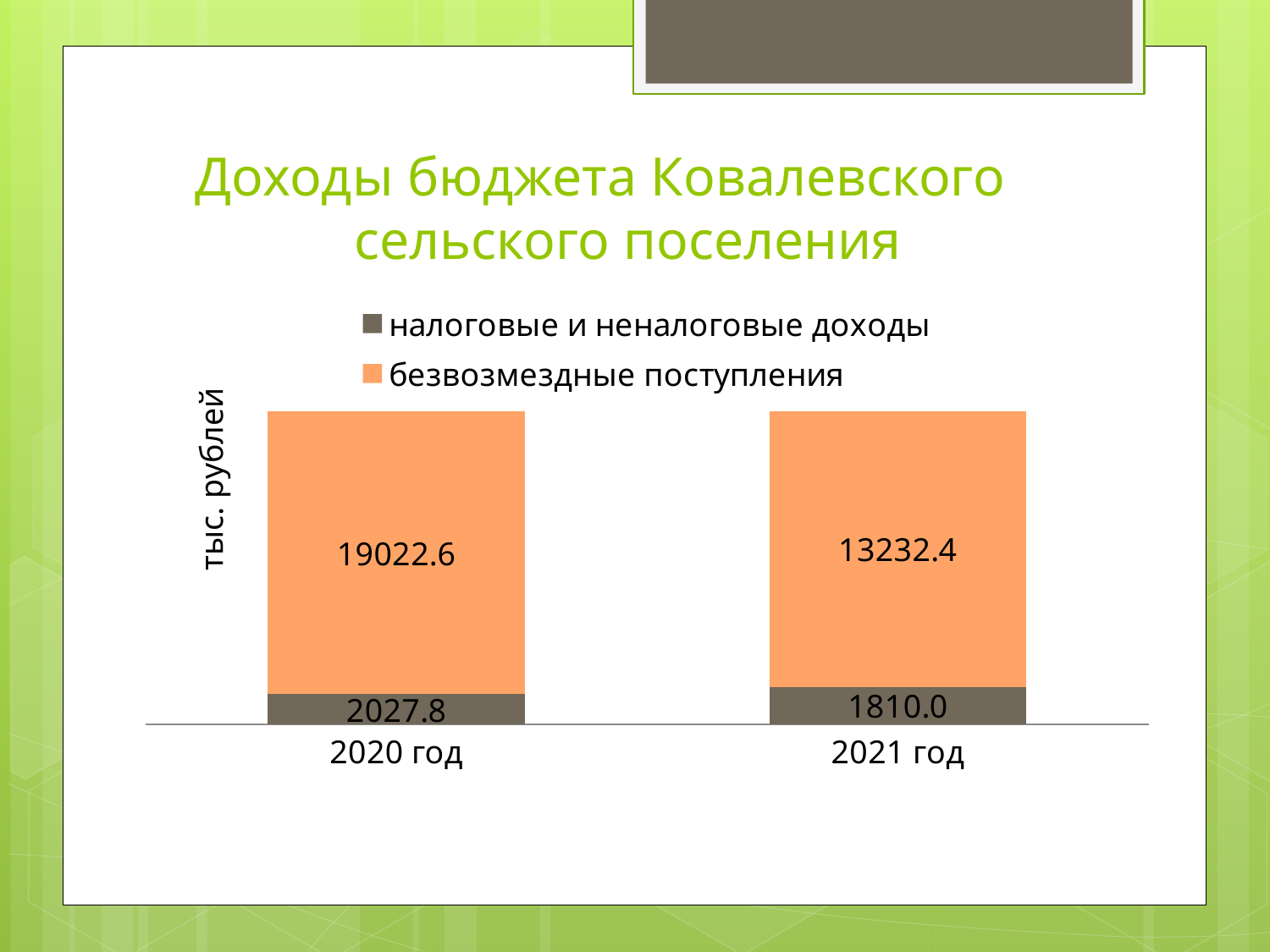
How many series does the legend list? 2 What is the value of налоговые и неналоговые доходы for 2021 год? 1810.0 What is the total of the stacked bar for 2021 год? 15042.4 What is the total of the stacked bar for 2020 год? 21050.4 What is the value of налоговые и неналоговые доходы for 2020 год? 2027.8 In which year is безвозмездные поступления higher? 2020 год In which year is налоговые и неналоговые доходы lower? 2021 год What is the value of безвозмездные поступления for 2020 год? 19022.6 What is the difference in налоговые и неналоговые доходы between 2020 год and 2021 год? 217.8 What is the value of безвозмездные поступления for 2021 год? 13232.4 What kind of chart is shown on the slide? Stacked bar chart What is the difference in безвозмездные поступления between 2020 год and 2021 год? 5790.2